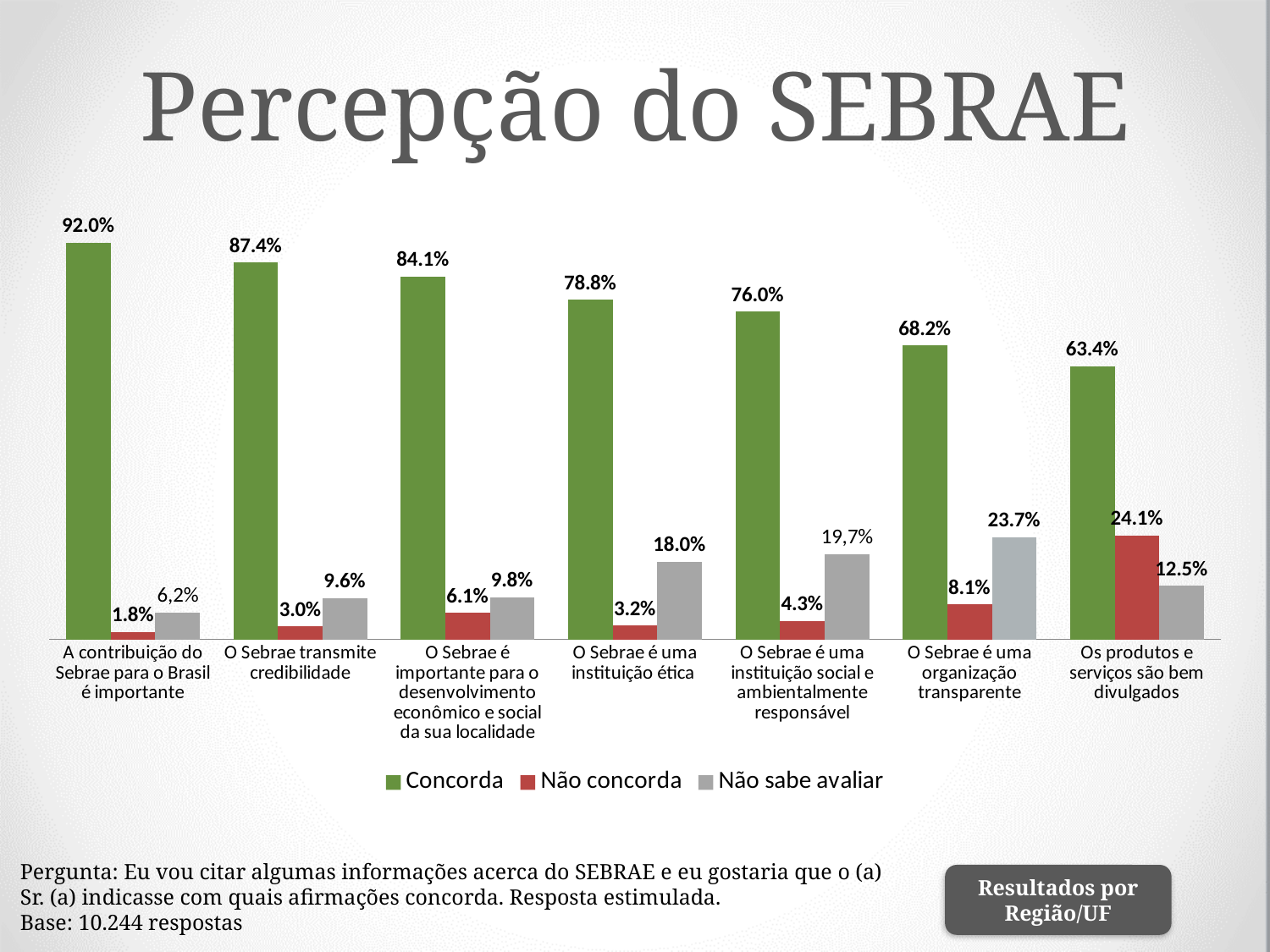
What is the 'Concorda' value for 'O Sebrae transmite credibilidade'? 87.4% Do the 'Concorda' values rise or fall from left to right along the x axis? Fall How many statements (categories) are shown on the x axis? 7 Which statement has the lowest 'Concorda' value? Os produtos e serviços são bem divulgados Which is larger: the 'Não sabe avaliar' value for 'O Sebrae é uma instituição ética' or for 'O Sebrae é uma instituição social e ambientalmente responsável'? O Sebrae é uma instituição social e ambientalmente responsável What is the 'Não concorda' value for 'Os produtos e serviços são bem divulgados'? 24.1% What is the difference between the 'Concorda' values for 'A contribuição do Sebrae para o Brasil é importante' and 'O Sebrae é uma instituição ética'? 13.2% Which statement has the highest 'Concorda' value? A contribuição do Sebrae para o Brasil é importante What kind of chart is shown on the slide? Bar chart What is the 'Não sabe avaliar' value for 'O Sebrae é uma organização transparente'? 23.7% Which series is shown in green in the legend? Concorda How many series does the legend list? 3